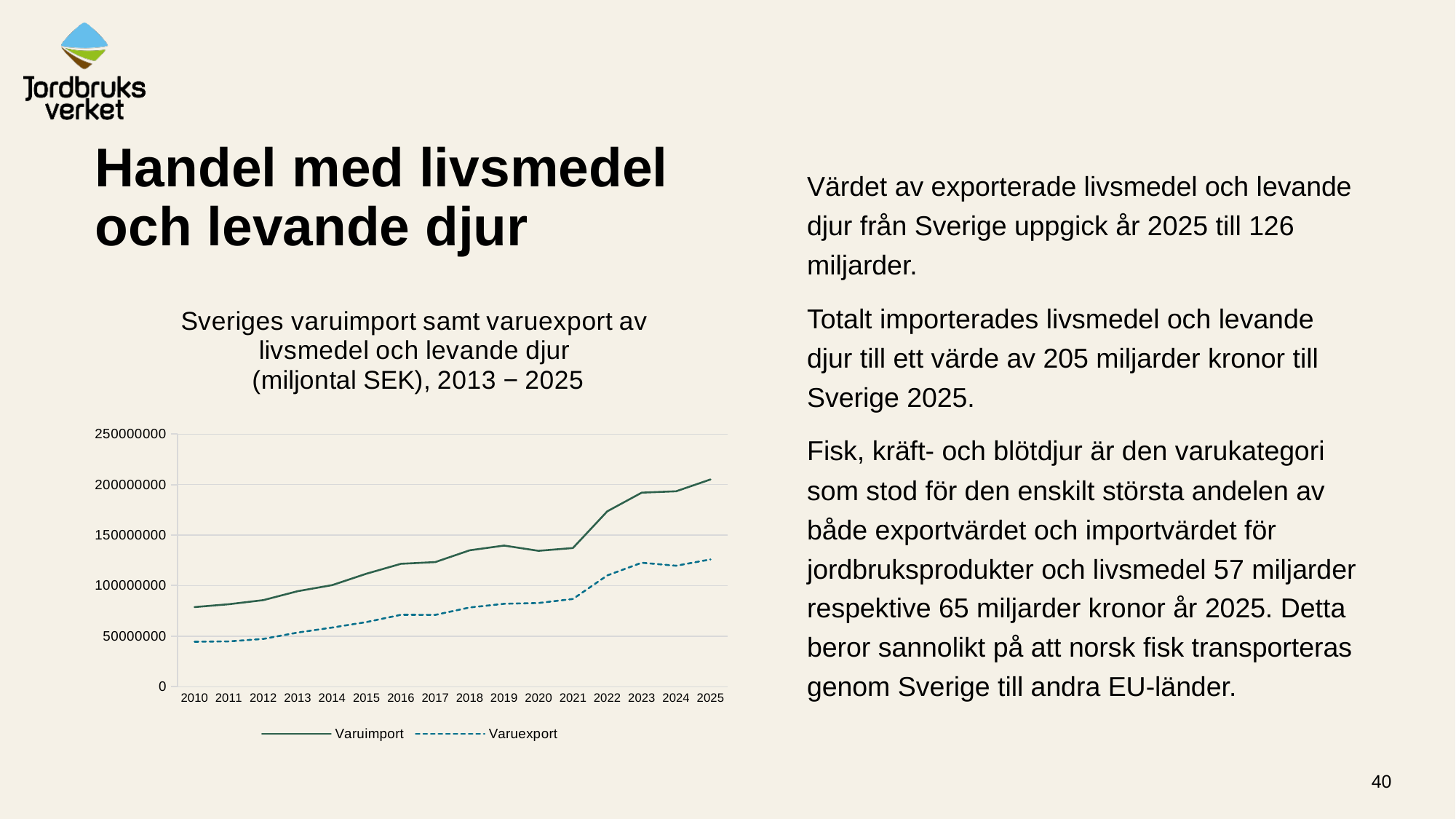
In 2025, which series has the higher value, Varuimport or Varuexport? Varuimport Which series is drawn with a dashed line in the chart? Varuexport How many series does the chart legend list? 2 Is the value for Varuimport in 2010 greater or less than 100000000? less Does the Varuimport series generally rise or fall from 2010 to 2025? rise Is the value for Varuexport in 2025 greater or less than 150000000? less In which year is the Varuexport series at its lowest value? 2010 Is the value for Varuimport in 2022 greater or less than 150000000? greater What kind of chart is shown on the slide? line chart In which year does the Varuimport series reach its highest value? 2025 How many years are shown on the x axis of the chart? 16 What is the first year shown on the x axis of the chart? 2010